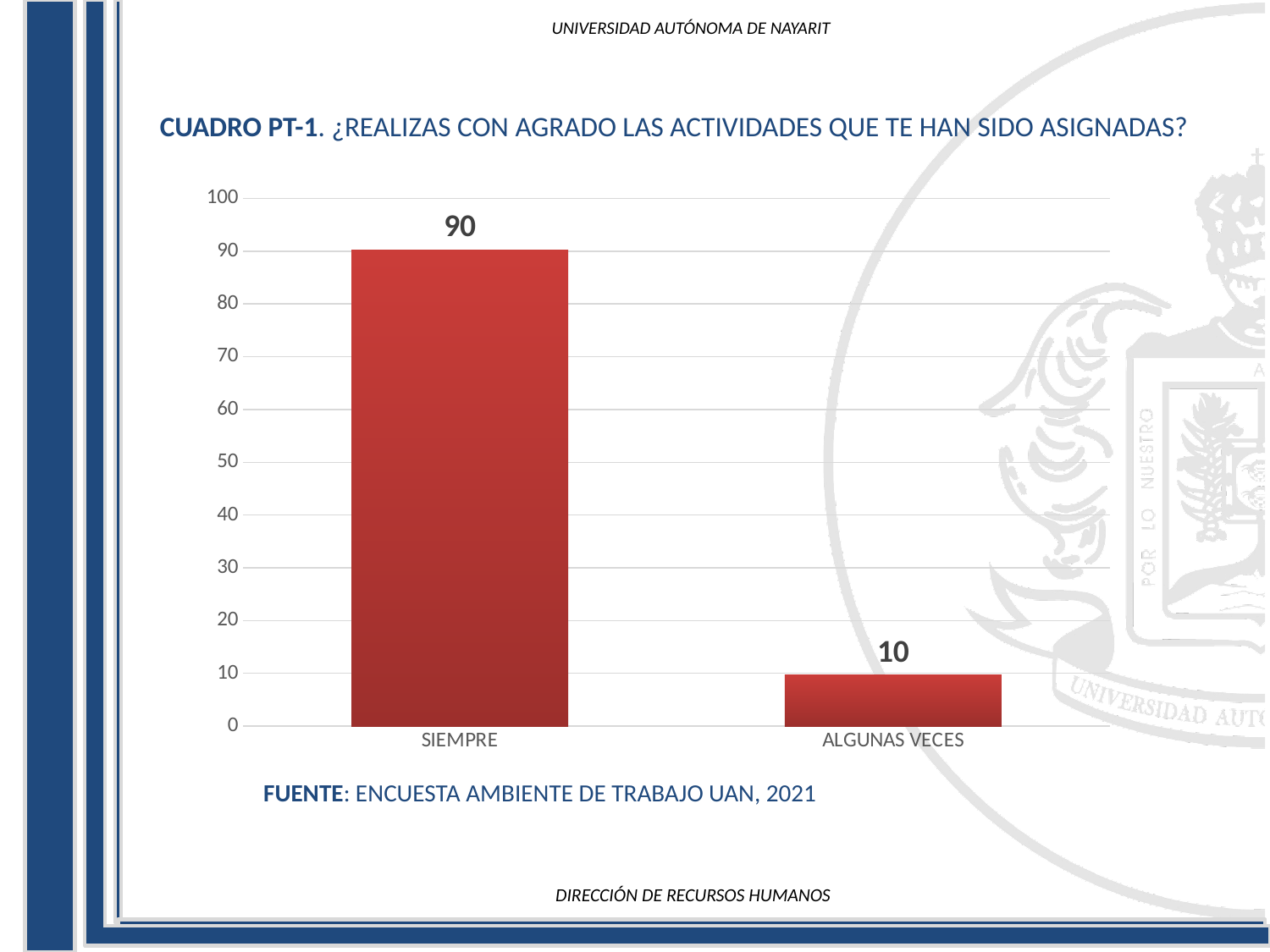
What kind of chart is shown on the slide? Bar chart Is the value for ALGUNAS VECES greater or less than 20? less Which category has the highest value? SIEMPRE How many categories are shown on the x axis? 2 What is the value for SIEMPRE? 90 Is the value for SIEMPRE greater or less than 50? greater What is the value for ALGUNAS VECES? 10 What is the source cited below the chart? ENCUESTA AMBIENTE DE TRABAJO UAN, 2021 What is the difference between the values for SIEMPRE and ALGUNAS VECES? 80 Which is larger, the value for SIEMPRE or the value for ALGUNAS VECES? SIEMPRE What is the total of the two values shown in the chart? 100 Which category has the lowest value? ALGUNAS VECES